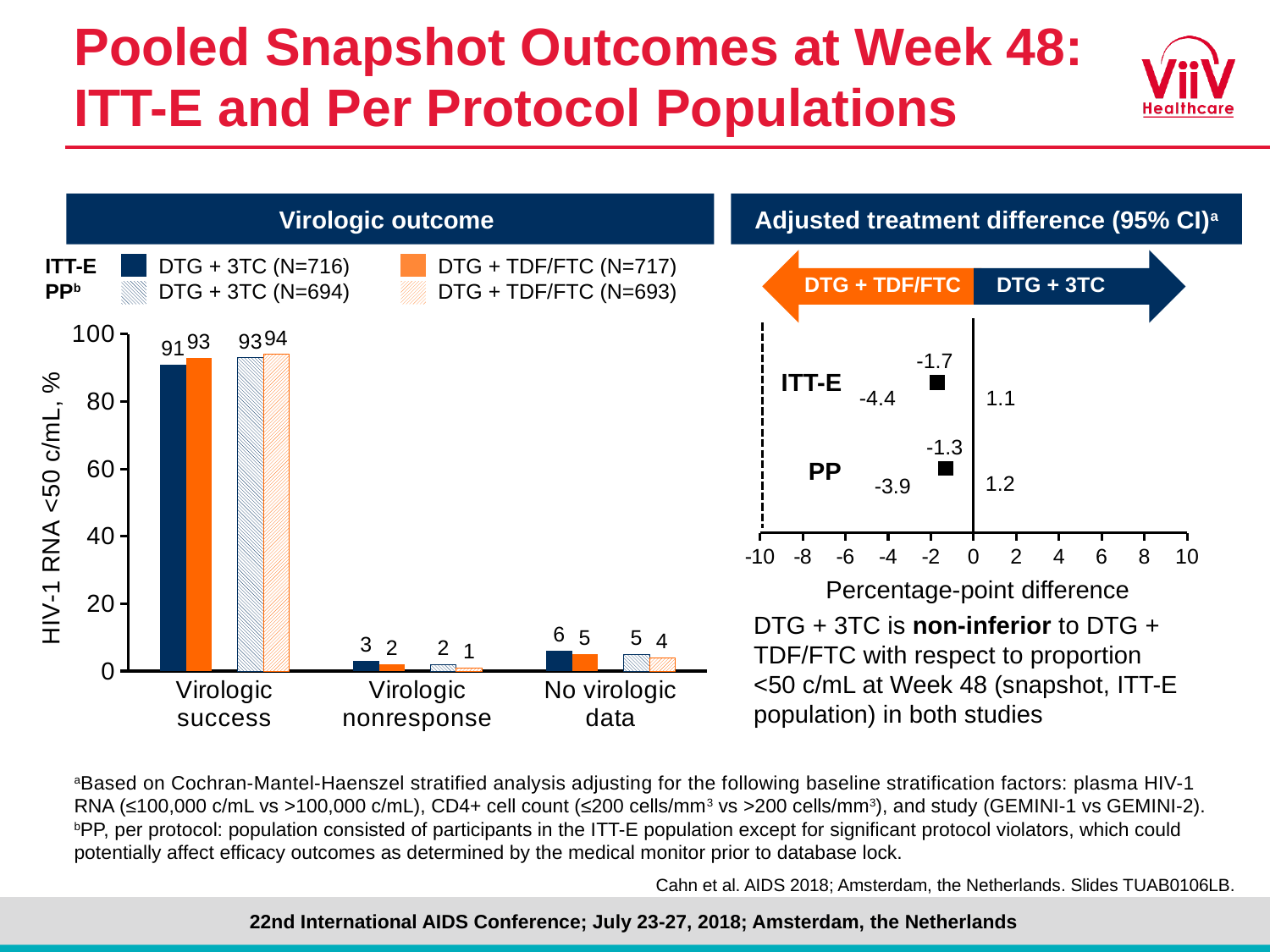
In the Virologic outcome chart, what is the difference between the ITT-E DTG + TDF/FTC and ITT-E DTG + 3TC values for Virologic success? 2 In the Adjusted treatment difference chart, what is the upper confidence limit for the PP population? 1.2 In the Virologic outcome chart, what is the value for DTG + TDF/FTC (N=693) in the PP population for Virologic success? 94 What kind of chart is the Virologic outcome chart? Bar chart In the Virologic outcome chart, what is the value for DTG + 3TC (N=716) in the ITT-E population for Virologic success? 91 In the Virologic outcome chart, what is the value for DTG + 3TC (N=716) in the ITT-E population for No virologic data? 6 In the Virologic outcome chart, which category has the highest values? Virologic success In the Adjusted treatment difference chart, what is the point estimate for the ITT-E population? -1.7 In the Virologic outcome chart, what is the value for DTG + TDF/FTC (N=717) in the ITT-E population for Virologic success? 93 In the Virologic outcome chart, how many categories are shown on the x axis? 3 In the Virologic outcome chart, how many series does the legend list? 4 In the Virologic outcome chart, what is the y-axis label? HIV-1 RNA <50 c/mL, %